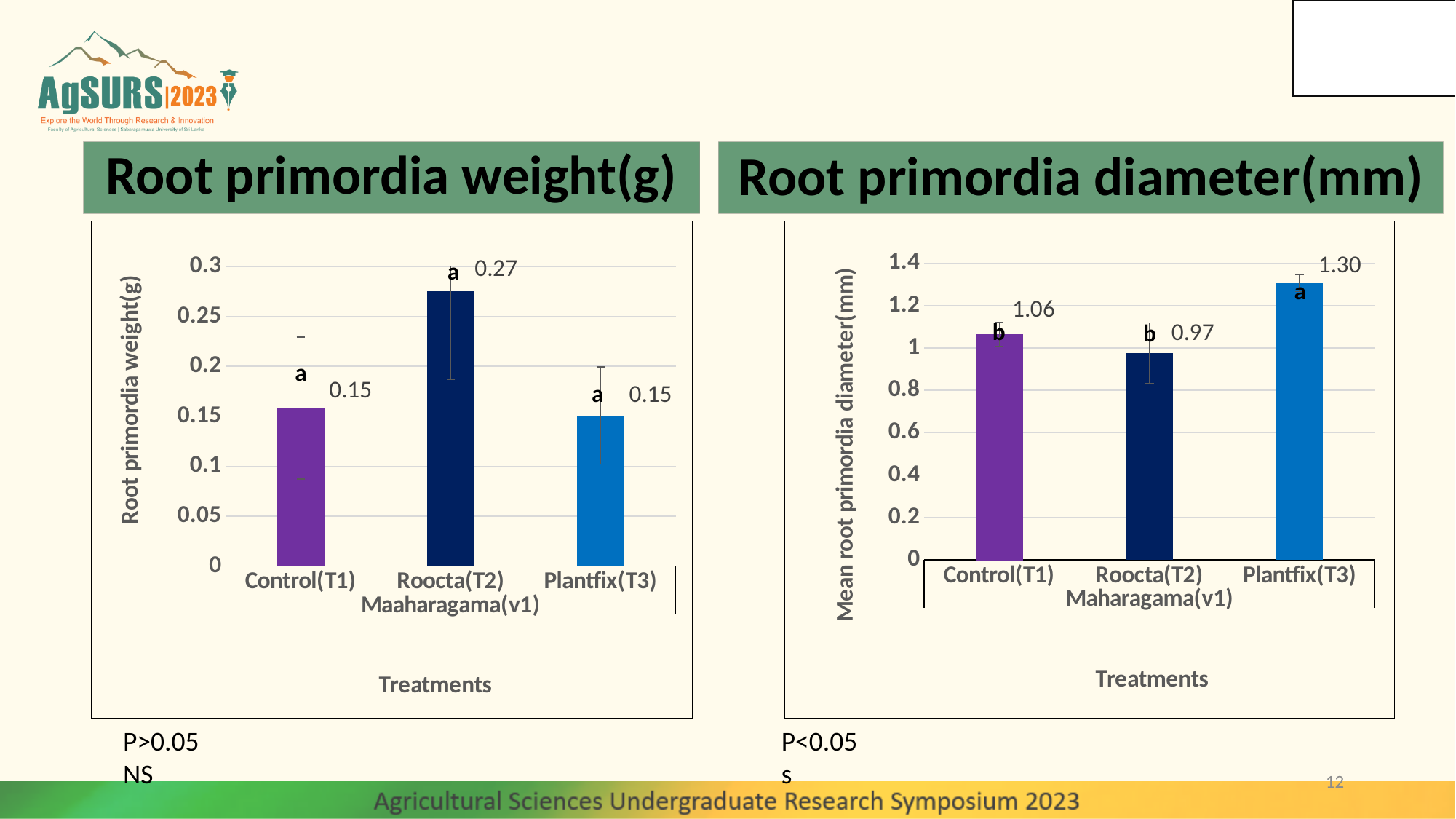
What kind of chart is the Root primordia diameter(mm) chart? bar chart In the Root primordia weight(g) chart, which treatment has the highest root primordia weight? Roocta(T2) In the Root primordia weight(g) chart, what is the value for Roocta(T2)? 0.27 What is the x-axis title of the Root primordia weight(g) chart? Treatments In the Root primordia diameter(mm) chart, is the value for Control(T1) larger or smaller than the value for Roocta(T2)? larger In the Root primordia diameter(mm) chart, what is the value for Roocta(T2)? 0.97 In the Root primordia weight(g) chart, what is the difference between the values for Roocta(T2) and Plantfix(T3)? 0.12 In the Root primordia diameter(mm) chart, which treatment has the lowest mean root primordia diameter? Roocta(T2) In the Root primordia diameter(mm) chart, what is the value for Plantfix(T3)? 1.30 In the Root primordia weight(g) chart, how many treatments are plotted? 3 In the Root primordia weight(g) chart, what is the value for Control(T1)? 0.15 In the Root primordia diameter(mm) chart, what is the difference between the values for Plantfix(T3) and Control(T1)? 0.24